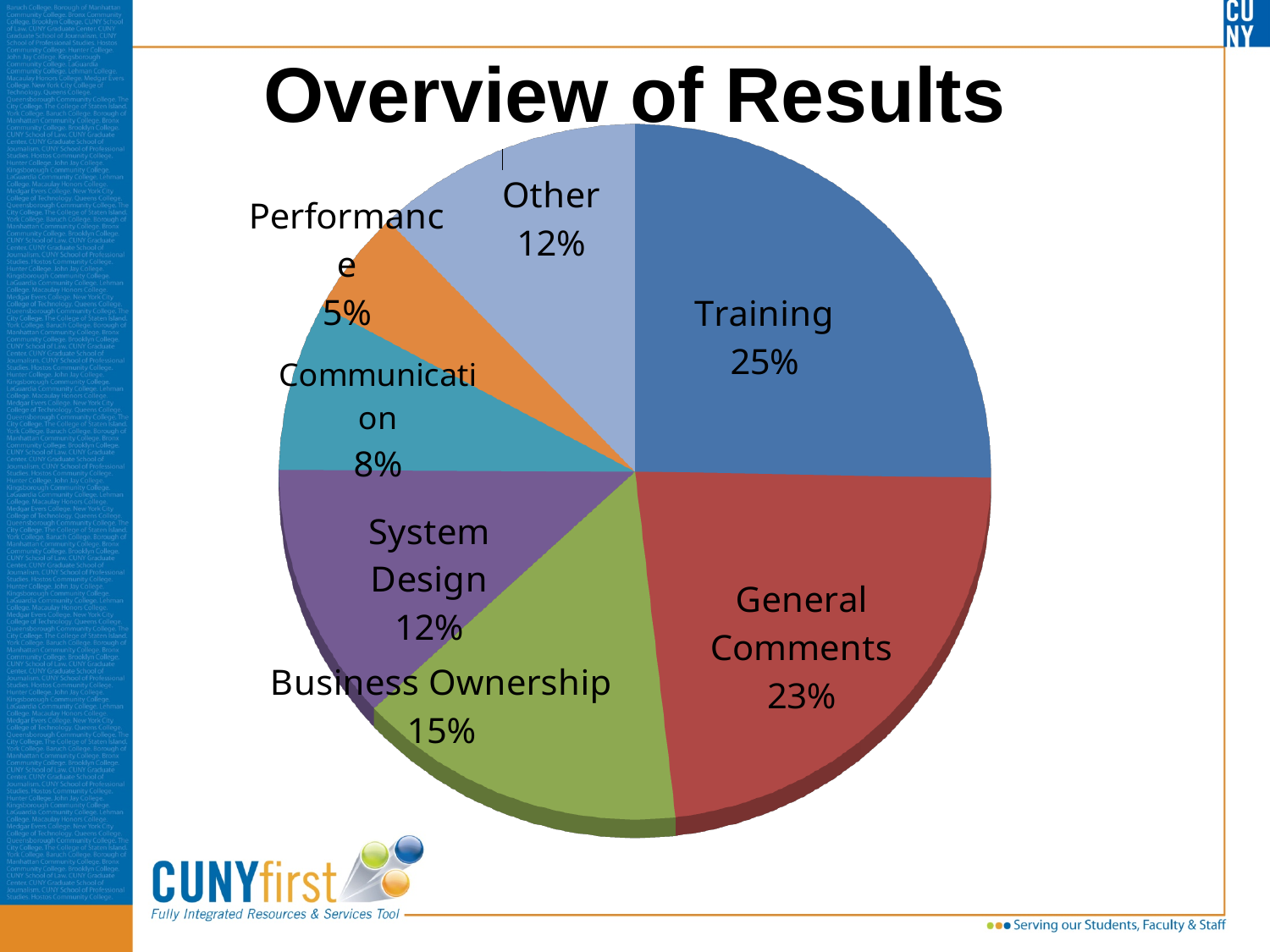
What percentage is shown for Communication? 8% What percentage is shown for Business Ownership? 15% What kind of chart is shown on the slide? pie chart What is the difference in percentage points between Training and General Comments? 2 What percentage is shown for General Comments? 23% What is the title of the slide containing the pie chart? Overview of Results How many slices does the pie chart have? 7 Which is larger, the share for Business Ownership or the share for System Design? Business Ownership What share of the pie does Training represent? 25% What percentage is shown for Performance? 5% Which category has the smallest slice of the pie? Performance Which category has the largest slice of the pie? Training